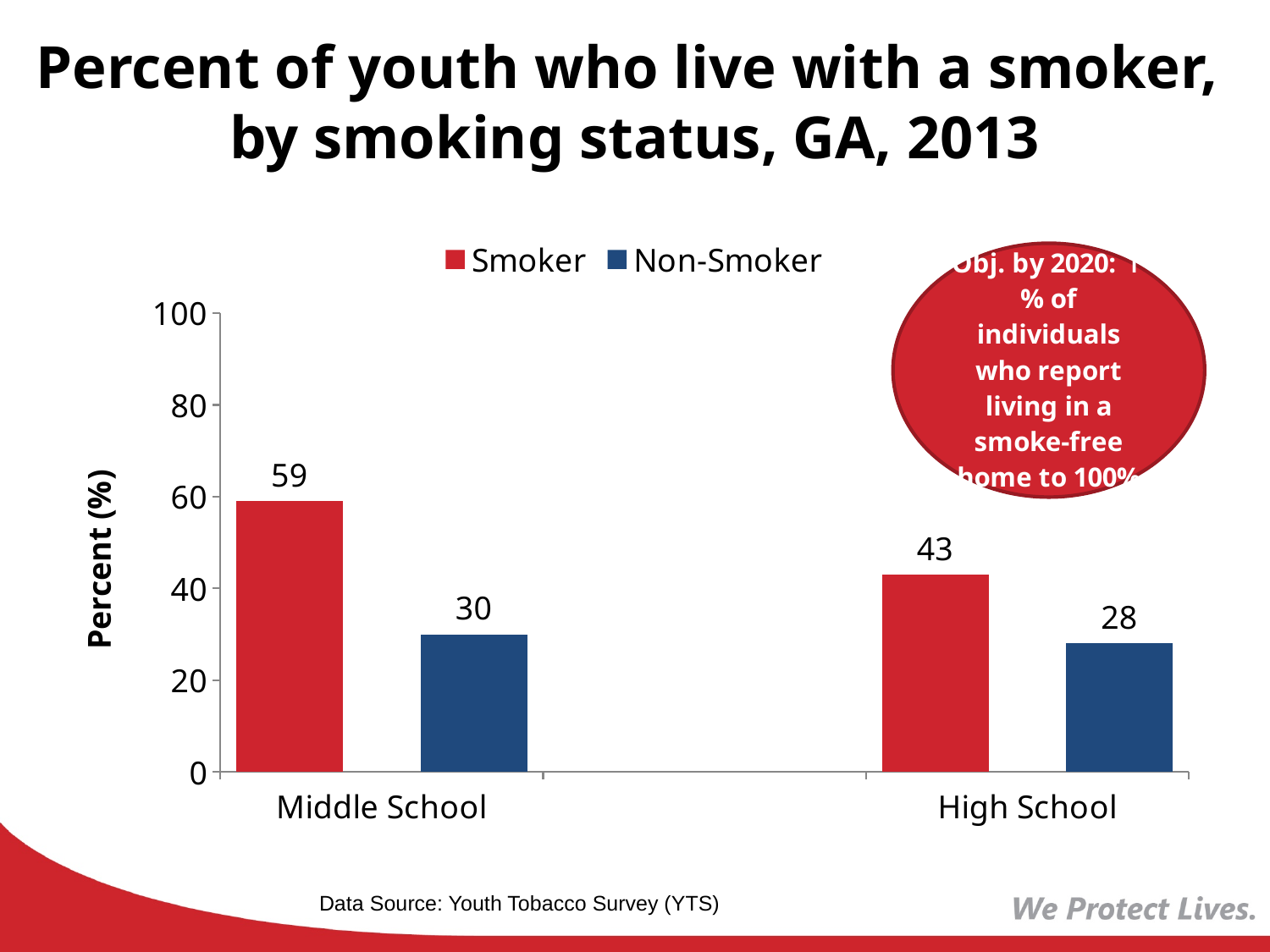
What kind of chart is shown on the slide? Bar chart Which bar has the highest value on the chart? Middle School Smoker Which bar has the lowest value on the chart? High School Non-Smoker What is the value for Smoker in the High School group? 43 How many series does the legend list? 2 What is the difference between the Smoker values for Middle School and High School? 16 What percent of Middle School smokers live with a smoker? 59 What is the value for Non-Smoker in the High School group? 28 What colour represents the Smoker series in the legend? Red What is the difference between the Smoker and Non-Smoker values for Middle School? 29 Which is larger: the Non-Smoker value for Middle School or for High School? Middle School What is the value for Non-Smoker in the Middle School group? 30